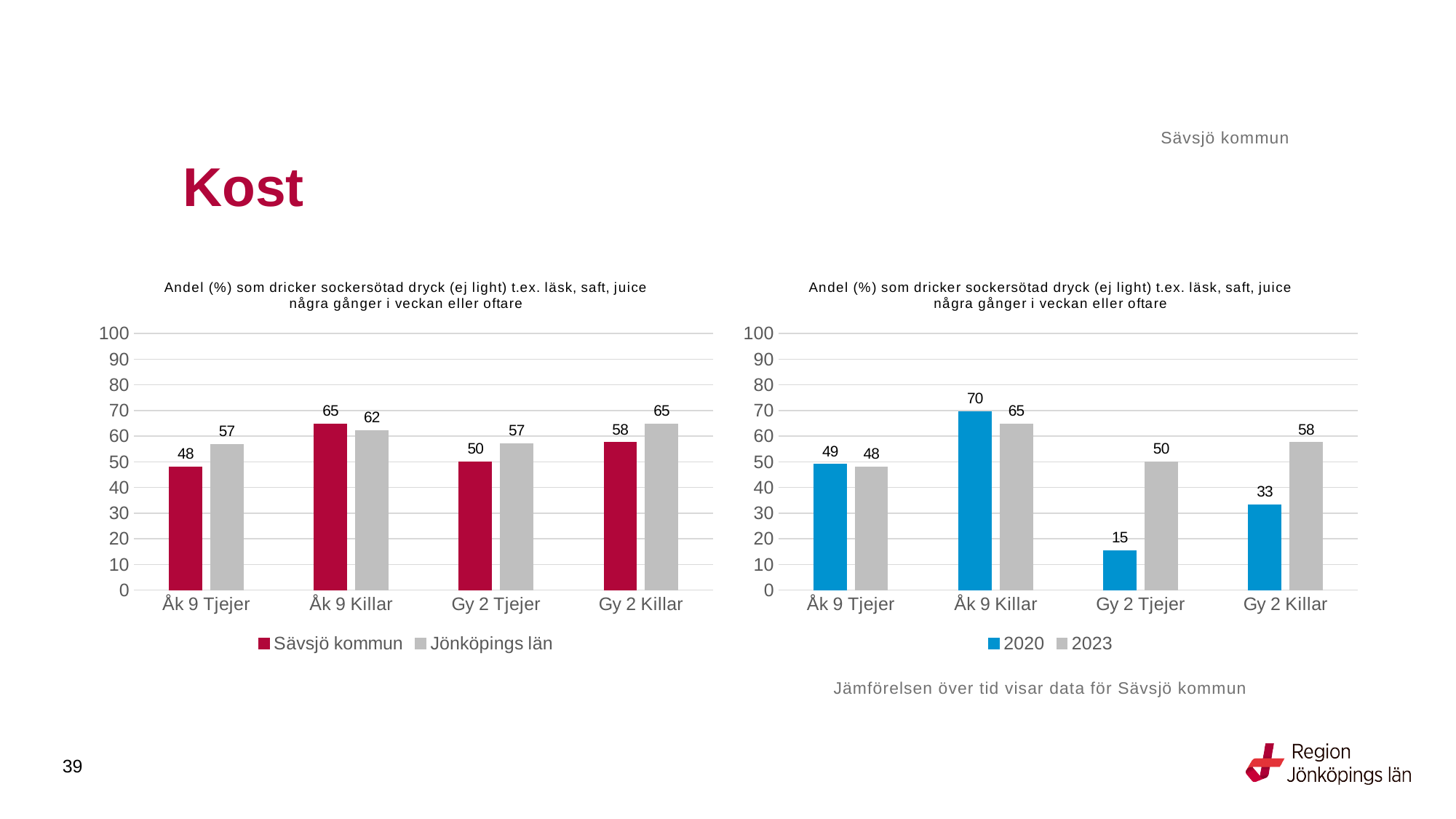
In the left chart, what is the value for Jönköpings län for Gy 2 Tjejer? 57 In the right chart, what is the difference between 2023 and 2020 for Gy 2 Tjejer? 35 In the left chart, which category has the highest value for Sävsjö kommun? Åk 9 Killar What kind of chart is the right chart? Bar chart In the left chart, what is the value for Sävsjö kommun for Åk 9 Killar? 65 In the right chart, how many series does the legend list? 2 In the right chart, which category has the lowest value for 2020? Gy 2 Tjejer In the right chart, what is the value for 2023 for Gy 2 Killar? 58 In the left chart, what is the difference between Jönköpings län and Sävsjö kommun for Åk 9 Tjejer? 9 In the right chart, what is the value for 2020 for Gy 2 Tjejer? 15 In the left chart, which is larger for Gy 2 Killar: Sävsjö kommun or Jönköpings län? Jönköpings län How many categories are shown on the x axis of the left chart? 4